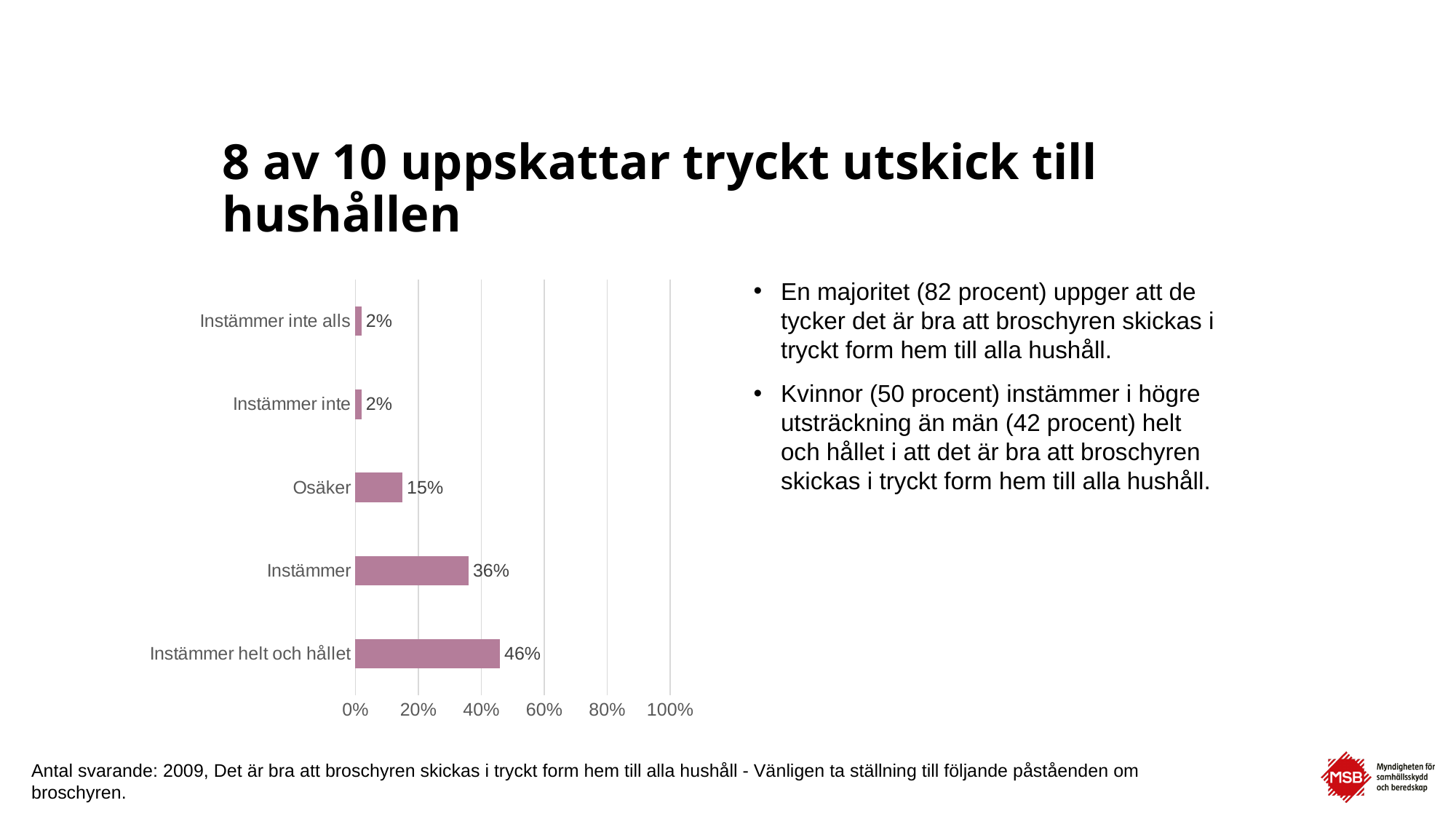
What is the combined value of "Instämmer helt och hållet" and "Instämmer"? 82% What is the value for "Instämmer helt och hållet"? 46% Which is larger, the value for "Osäker" or the value for "Instämmer"? Instämmer What kind of chart is shown on the slide? Bar chart What is the value for "Osäker"? 15% Is the value for "Instämmer helt och hållet" greater or less than 40%? greater How many categories are shown in the chart? 5 What is the difference between the values for "Instämmer" and "Osäker"? 21% Which category has the highest value? Instämmer helt och hållet What is the difference between the values for "Instämmer helt och hållet" and "Instämmer"? 10% What is the value for "Instämmer inte alls"? 2% What is the value for "Instämmer"? 36%